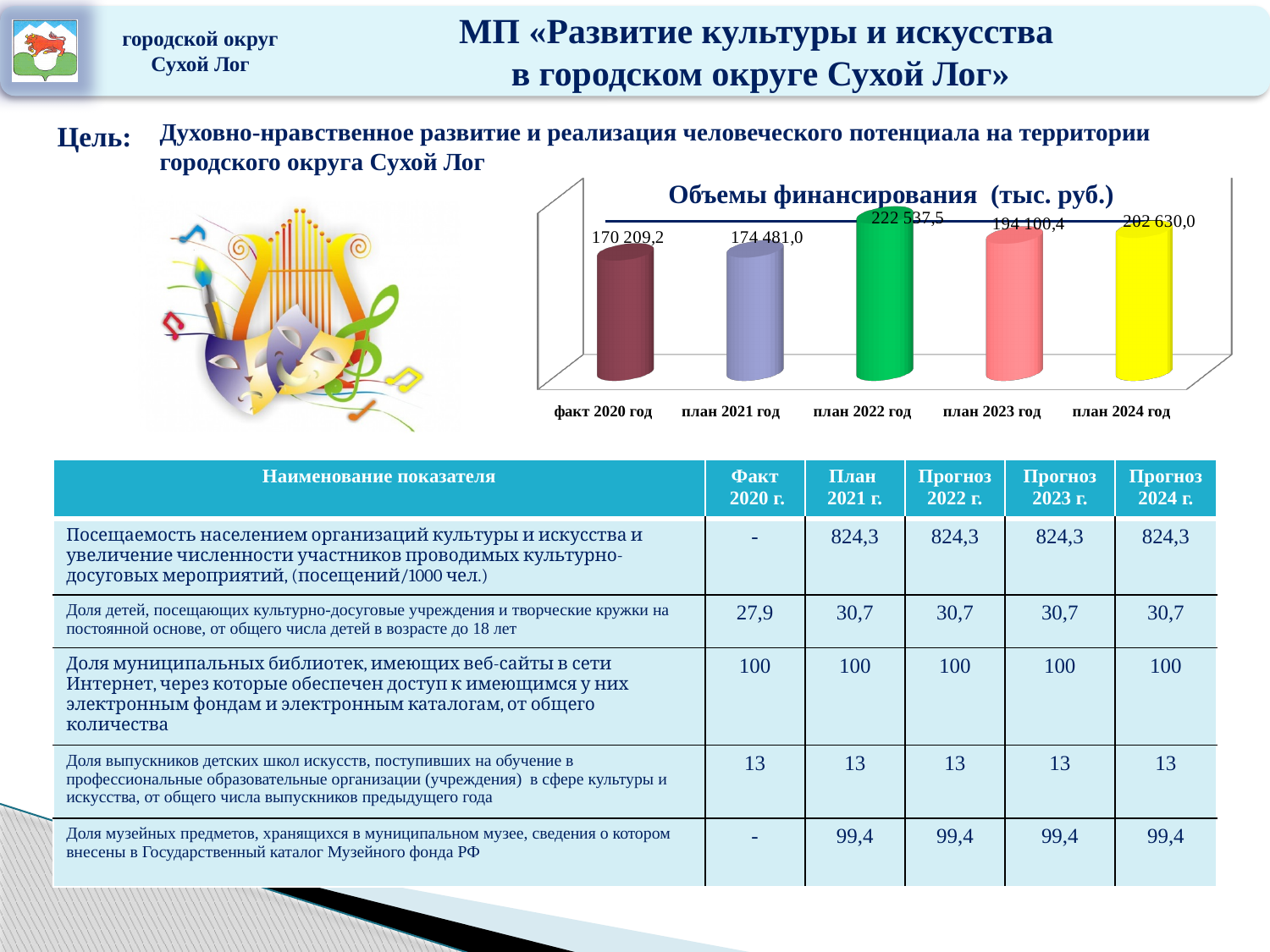
What is the difference between the values for план 2022 год and план 2021 год in the chart? 48 056,5 What is the title of the chart on the slide? Объемы финансирования (тыс. руб.) What is the value for план 2023 год in the chart? 194 100,4 What type of chart is shown on the slide? bar chart What is the value for план 2022 год in the chart? 222 537,5 What is the value for план 2024 год in the chart? 202 630,0 Which is larger in the chart: the value for план 2023 год or план 2024 год? план 2024 год How many categories (years) are shown in the chart? 5 Which category has the lowest value in the chart? факт 2020 год What is the value for факт 2020 год in the chart? 170 209,2 Which category has the highest value in the chart? план 2022 год What is the value for план 2021 год in the chart? 174 481,0